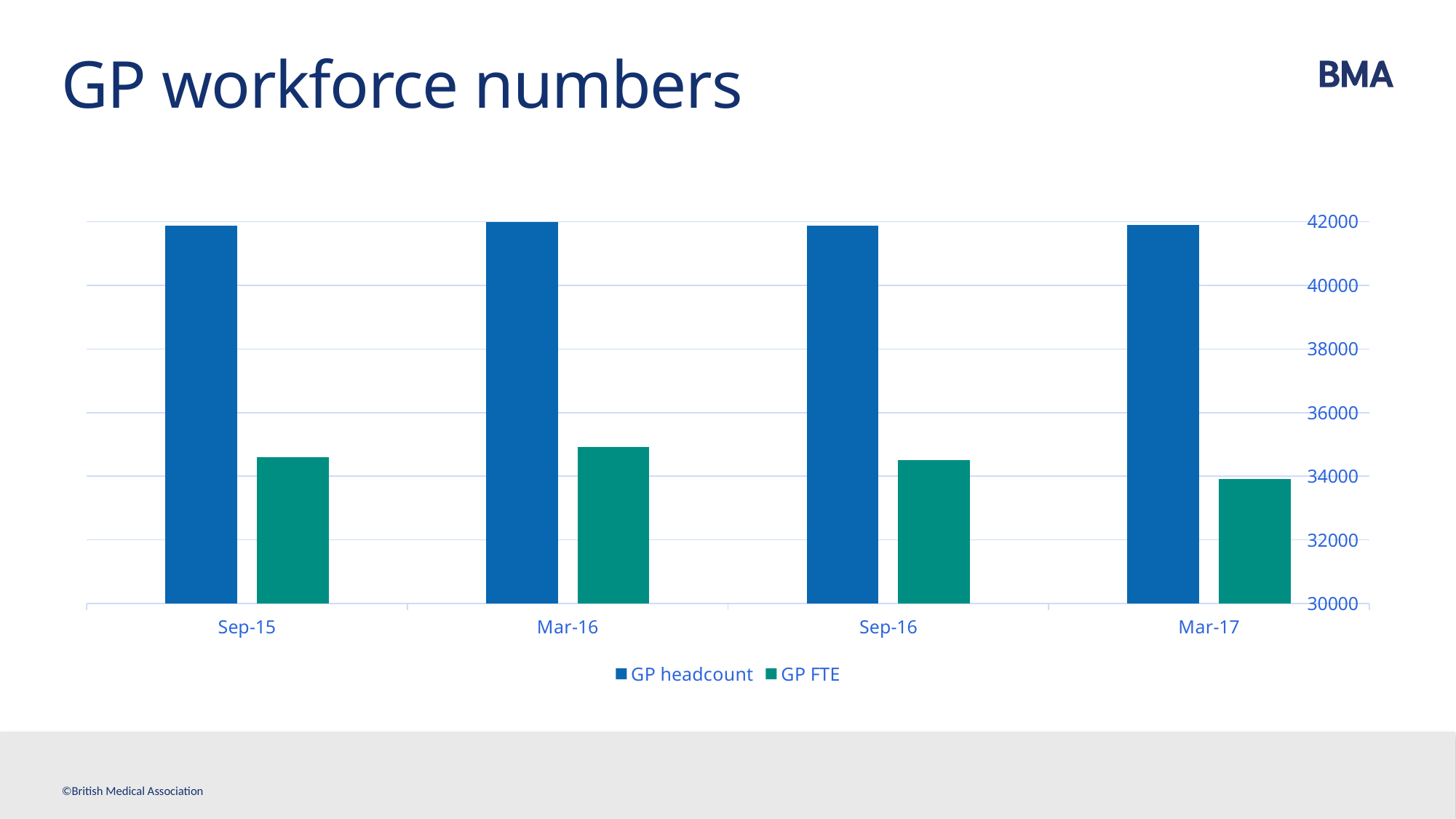
How many time periods are shown on the x axis? 4 What is the title of the chart? GP workforce numbers Which period has the lowest GP FTE value? Mar-17 How many series does the legend list? 2 Does the GP FTE value rise or fall from Mar-16 to Mar-17? fall Is the GP headcount value for Sep-16 greater or less than 40000? greater Is the GP FTE value for Sep-15 greater or less than 34000? greater Which series has the lowest value at Mar-17? GP FTE Which is larger: GP FTE at Sep-15 or GP FTE at Mar-17? GP FTE at Sep-15 What kind of chart is shown on the slide? bar chart Is the GP FTE value for Mar-16 greater or less than 36000? less Which is larger at Sep-16: GP headcount or GP FTE? GP headcount